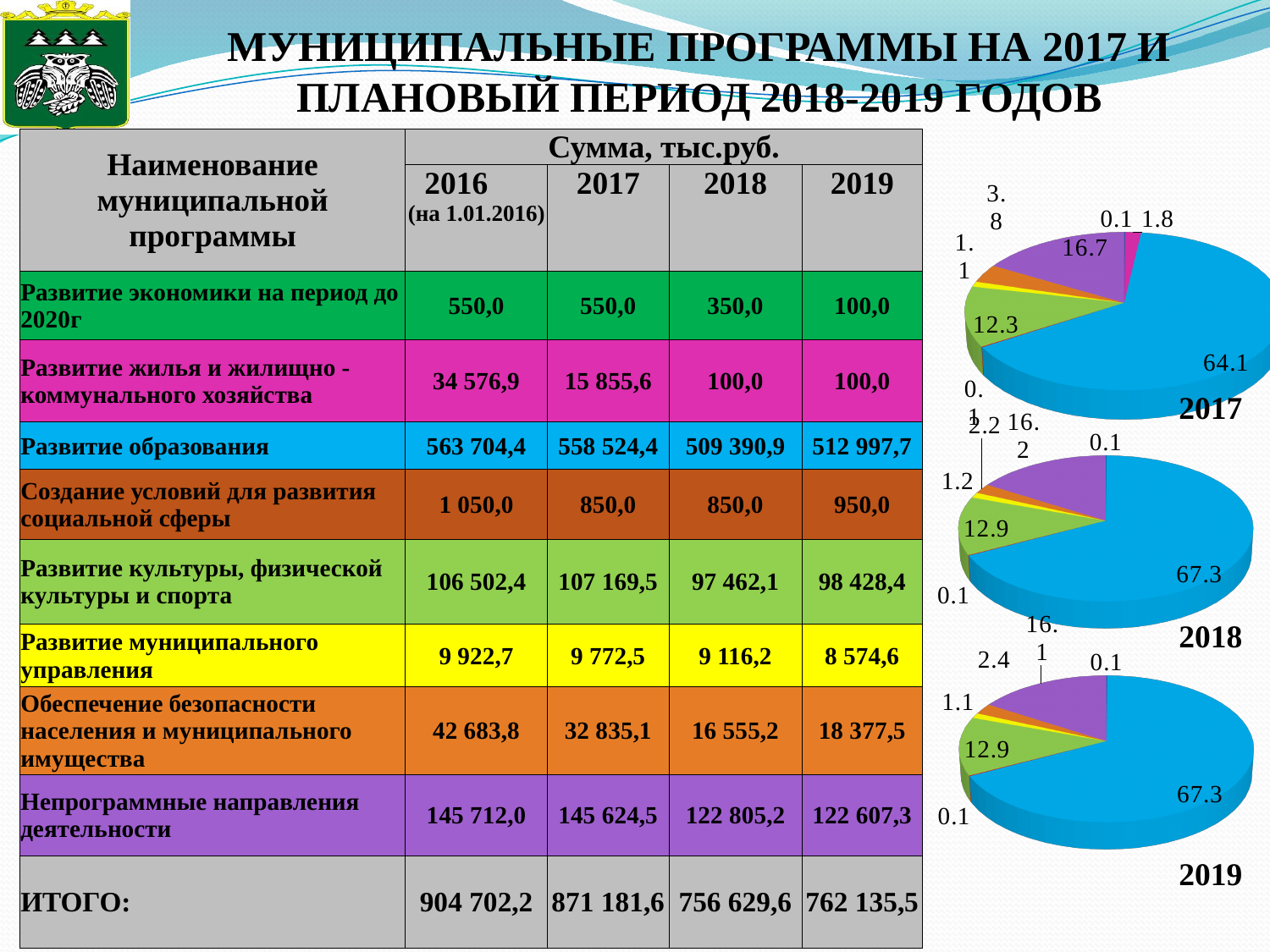
What kind of charts are shown on the right side of the slide? Pie charts Which is larger: the largest slice in the 2017 pie chart or the largest slice in the 2018 pie chart? 2018 How many pie charts are on the slide? 3 In the pie chart labeled 2018, what is the value of the largest slice? 67.3 In the pie chart labeled 2017, what is the value of the largest slice? 64.1 What is the difference between the largest slice in the 2018 pie chart (67.3) and the largest slice in the 2017 pie chart (64.1)? 3.2 In the pie chart labeled 2017, what value is shown for the green slice? 12.3 Which years are the three pie charts labeled with? 2017, 2018, 2019 In the pie chart labeled 2017, what value is shown for the purple slice? 16.7 In the pie chart labeled 2019, what value is shown for the green slice? 12.9 In the pie chart labeled 2018, what value is shown for the green slice? 12.9 In the pie chart labeled 2019, what is the value of the largest slice? 67.3